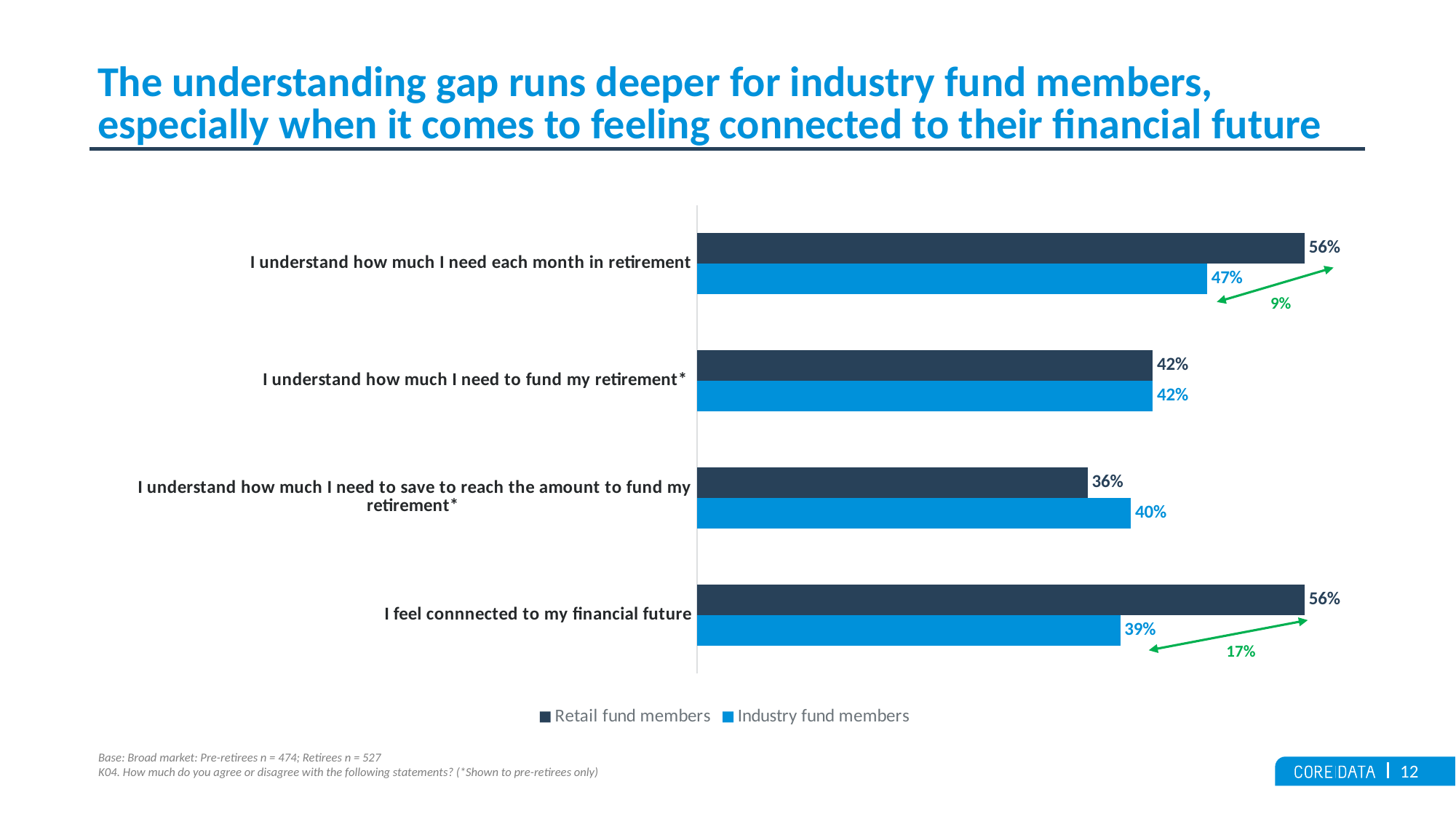
Which statement has the highest value for industry fund members? I understand how much I need each month in retirement What is the difference between retail fund members and industry fund members for 'I understand how much I need each month in retirement'? 9% Which series is shown in dark navy in the legend? Retail fund members What is the difference between retail fund members and industry fund members for 'I feel connected to my financial future'? 17% What kind of chart is shown on the slide? Bar chart For 'I understand how much I need to save to reach the amount to fund my retirement', which group has the larger value, retail fund members or industry fund members? Industry fund members What percentage of retail fund members say they understand how much they need each month in retirement? 56% What percentage of industry fund members say they understand how much they need to save to reach the amount to fund their retirement? 40% What percentage of industry fund members say they feel connected to their financial future? 39% How many series does the legend list? 2 Which statement has the lowest value for retail fund members? I understand how much I need to save to reach the amount to fund my retirement* How many statements are shown on the chart? 4